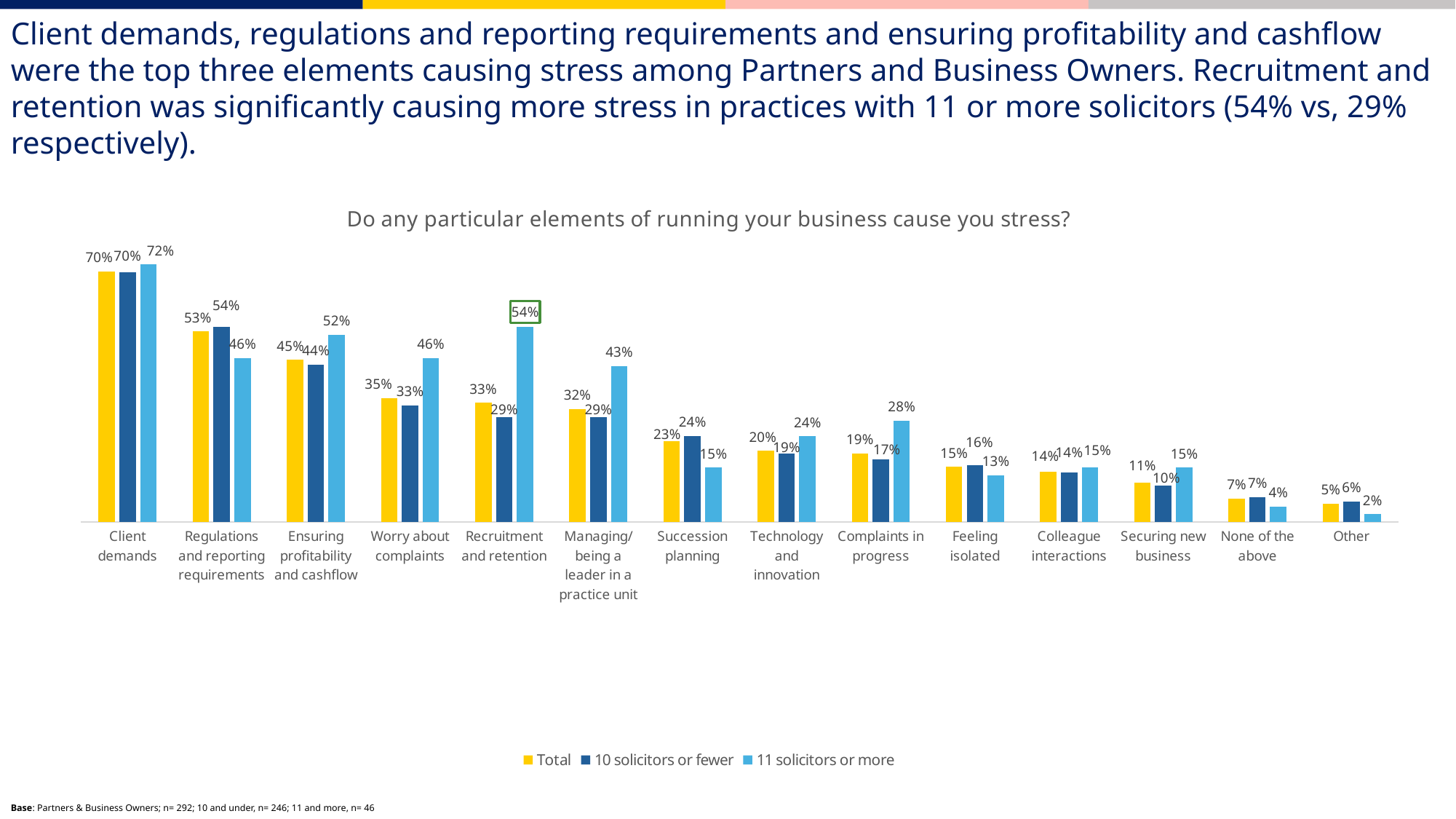
How many categories are shown on the x axis? 14 What is the Total value for Client demands? 70% Which category has the lowest value for 11 solicitors or more? Other What is the value for 10 solicitors or fewer for Managing/being a leader in a practice unit? 29% What is the Total value for Succession planning? 23% For Regulations and reporting requirements, which is larger: the value for 10 solicitors or fewer or for 11 solicitors or more? 10 solicitors or fewer What is the difference between the 11 solicitors or more and 10 solicitors or fewer values for Recruitment and retention? 25% How many series does the legend list? 3 What kind of chart is shown? Bar chart What is the title of the chart? Do any particular elements of running your business cause you stress? What is the value for 11 solicitors or more for Recruitment and retention? 54% Which category has the highest Total value? Client demands